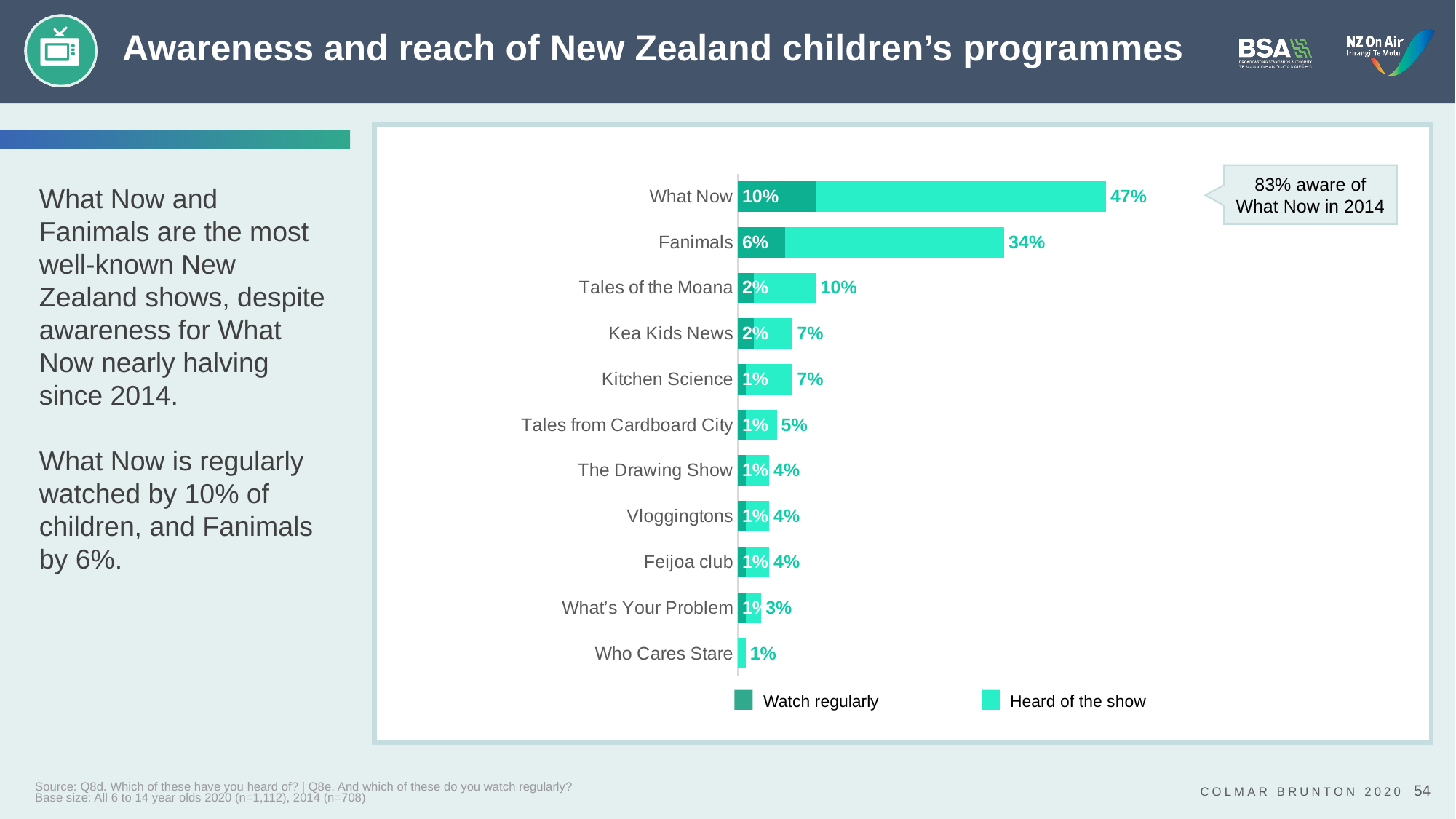
What is the Heard of the show value shown for Fanimals? 34% How many series does the chart legend list? 2 Which programme has the highest Heard of the show value? What Now What is the Watch regularly value shown for Tales of the Moana? 2% What is the Heard of the show value shown for Tales from Cardboard City? 5% According to the callout on the chart, what percentage were aware of What Now in 2014? 83% What is the Watch regularly value shown for What Now? 10% Which has a larger Heard of the show value, Fanimals or Tales of the Moana? Fanimals How many programmes are listed in the chart? 11 Which programme has the lowest Heard of the show value? Who Cares Stare What is the difference between the Watch regularly values for What Now and Fanimals? 4 percentage points What kind of chart is shown on the slide? Bar chart